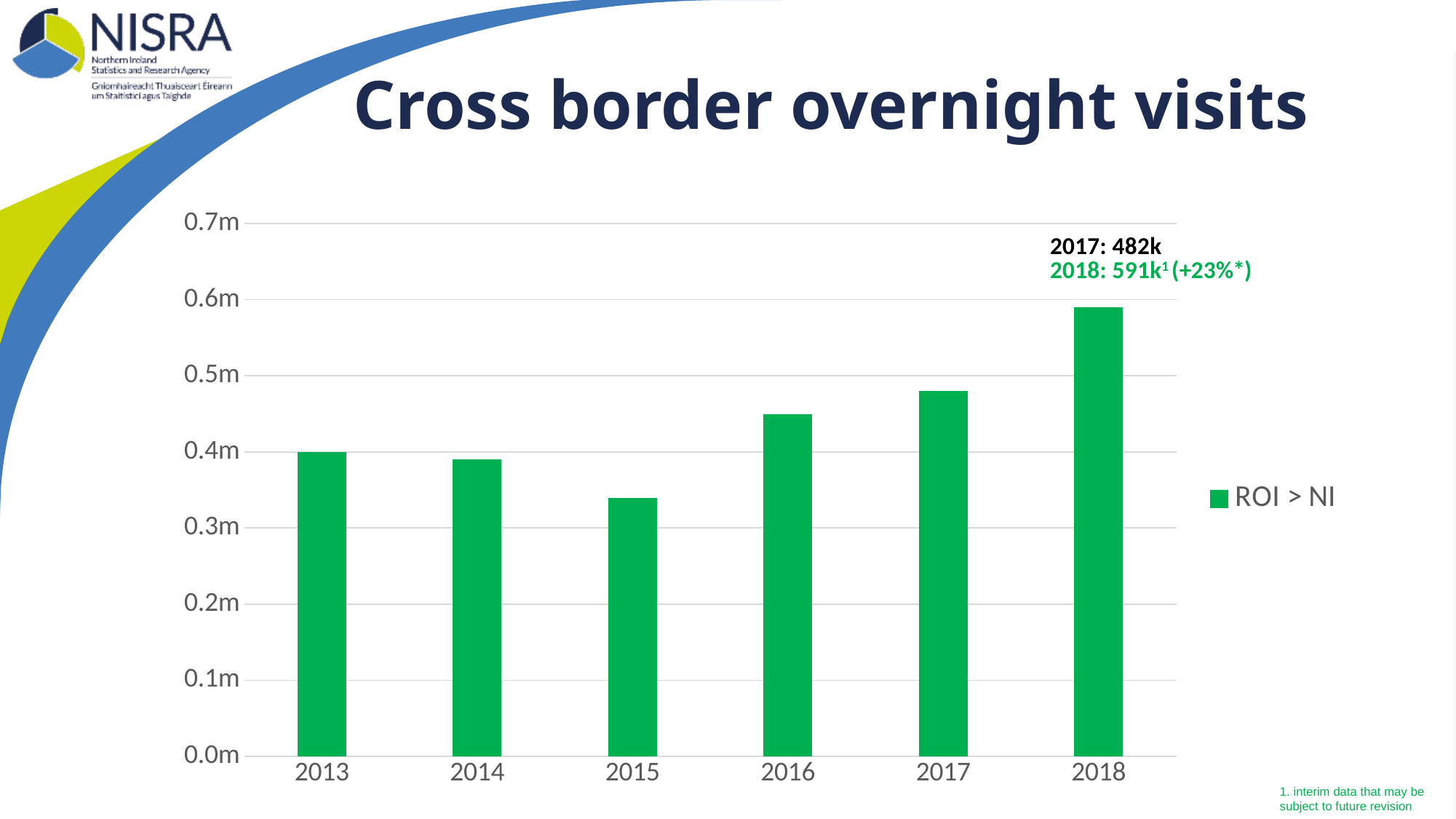
Which year has the highest value? 2018 How many years are shown on the x axis? 6 What kind of chart is shown on the slide? bar chart Is the value for 2016 greater or less than 0.4m? greater What is the name of the series shown in the legend? ROI > NI What is the value for 2017 according to the annotation on the chart? 482k What is the difference between the 2018 value and the 2017 value? 109k What is the title of the chart on the slide? Cross border overnight visits Which is larger, the value for 2016 or the value for 2014? 2016 What is the value for 2018 according to the annotation on the chart? 591k Which year has the lowest value? 2015 Is the value for 2015 greater or less than 0.4m? less